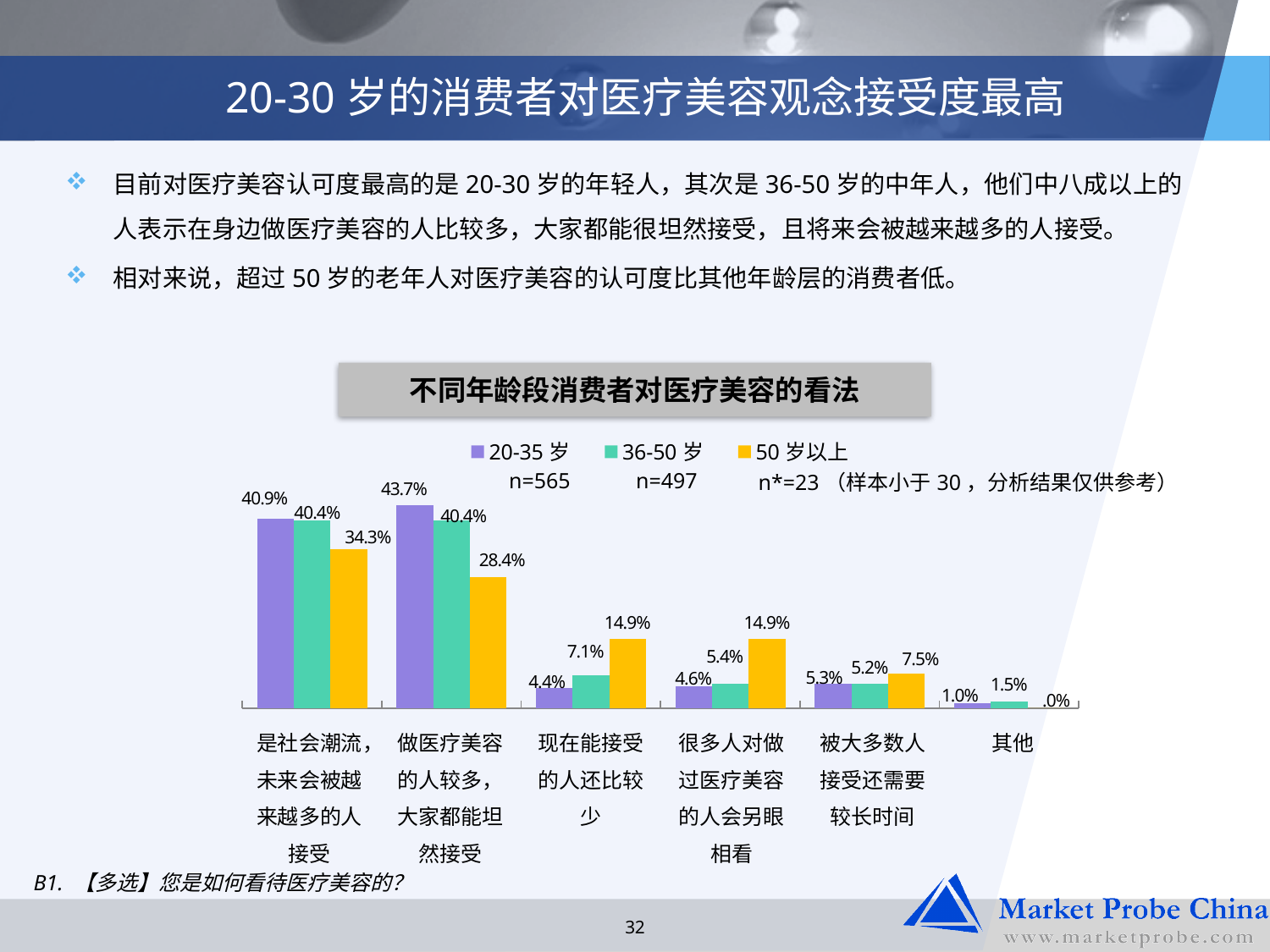
Which category has the highest value for the 20-35 岁 series? 做医疗美容的人较多，大家都能坦然接受 In the category 很多人对做过医疗美容的人会另眼相看, which series has the larger value: 36-50 岁 or 50 岁以上? 50 岁以上 How many series does the chart legend list? 3 What is the value for 36-50 岁 in the category 现在能接受的人还比较少? 7.1% What is the value for 50 岁以上 in the category 是社会潮流，未来会被越来越多的人接受? 34.3% What is the difference between the 20-35 岁 and 50 岁以上 values in the category 做医疗美容的人较多，大家都能坦然接受? 15.3% What is the sample size (n) shown for the 36-50 岁 series? n=497 What is the title of the chart? 不同年龄段消费者对医疗美容的看法 What is the value for 20-35 岁 in the category 做医疗美容的人较多，大家都能坦然接受? 43.7% What type of chart is shown on the slide? Bar chart Which category has the lowest value for the 50 岁以上 series? 其他 How many categories are shown on the x axis of the chart? 6